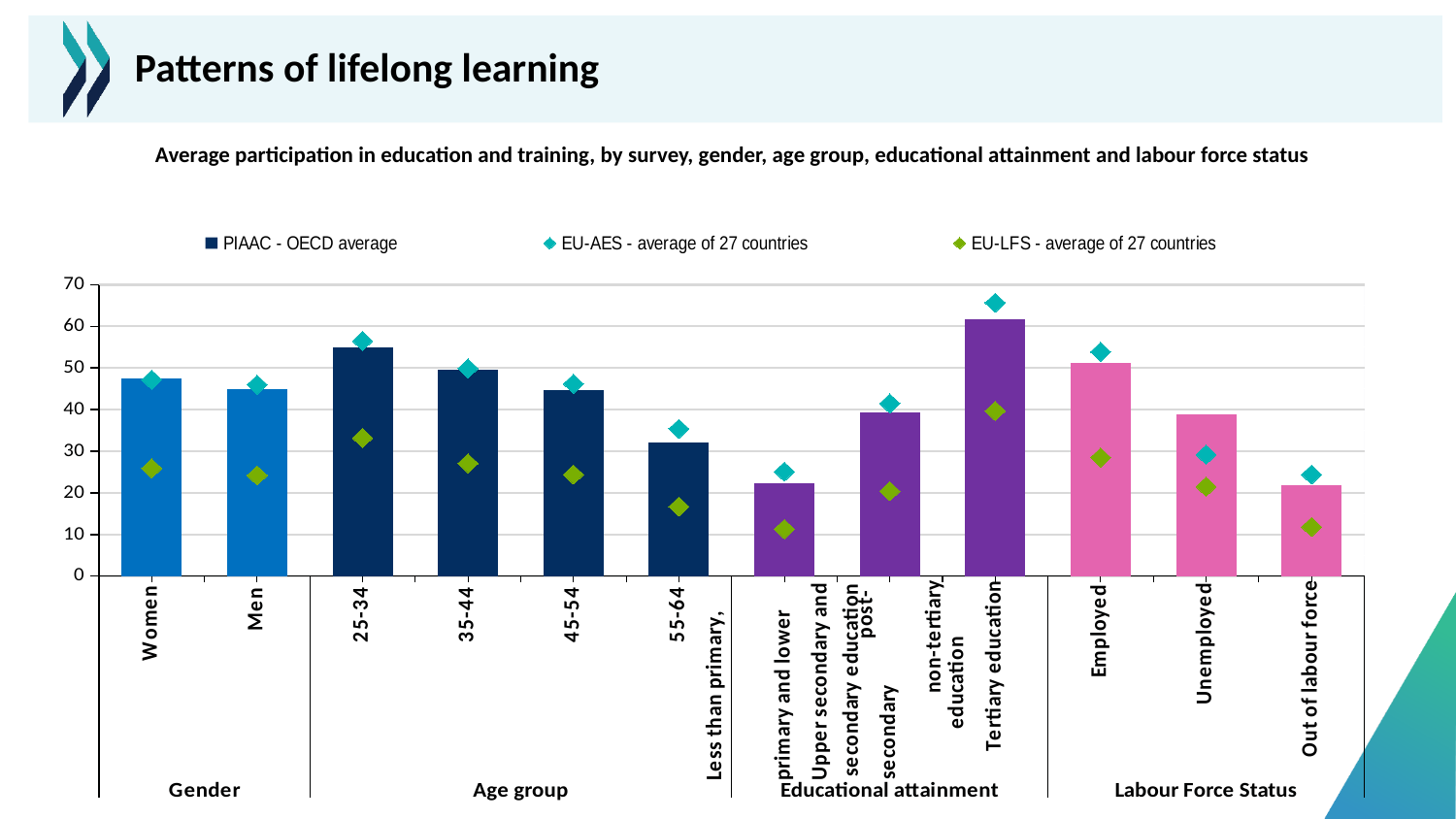
Within the Age group section, which category has the lowest PIAAC - OECD average bar? 55-64 What kind of chart is shown on the slide? bar chart Which series is plotted as bars rather than diamond markers? PIAAC - OECD average How many series does the legend list? 3 How many categories are plotted along the x axis? 12 Is the EU-AES value for Tertiary education greater or less than 60? greater Do the PIAAC - OECD average bars rise or fall across the age groups from 25-34 to 55-64? fall Which has the larger PIAAC - OECD average value, Employed or Unemployed? Employed Which category has the highest PIAAC - OECD average bar? Tertiary education Is the EU-LFS value for Less than primary greater or less than 20? less Is the PIAAC - OECD average value for 25-34 greater or less than 50? greater